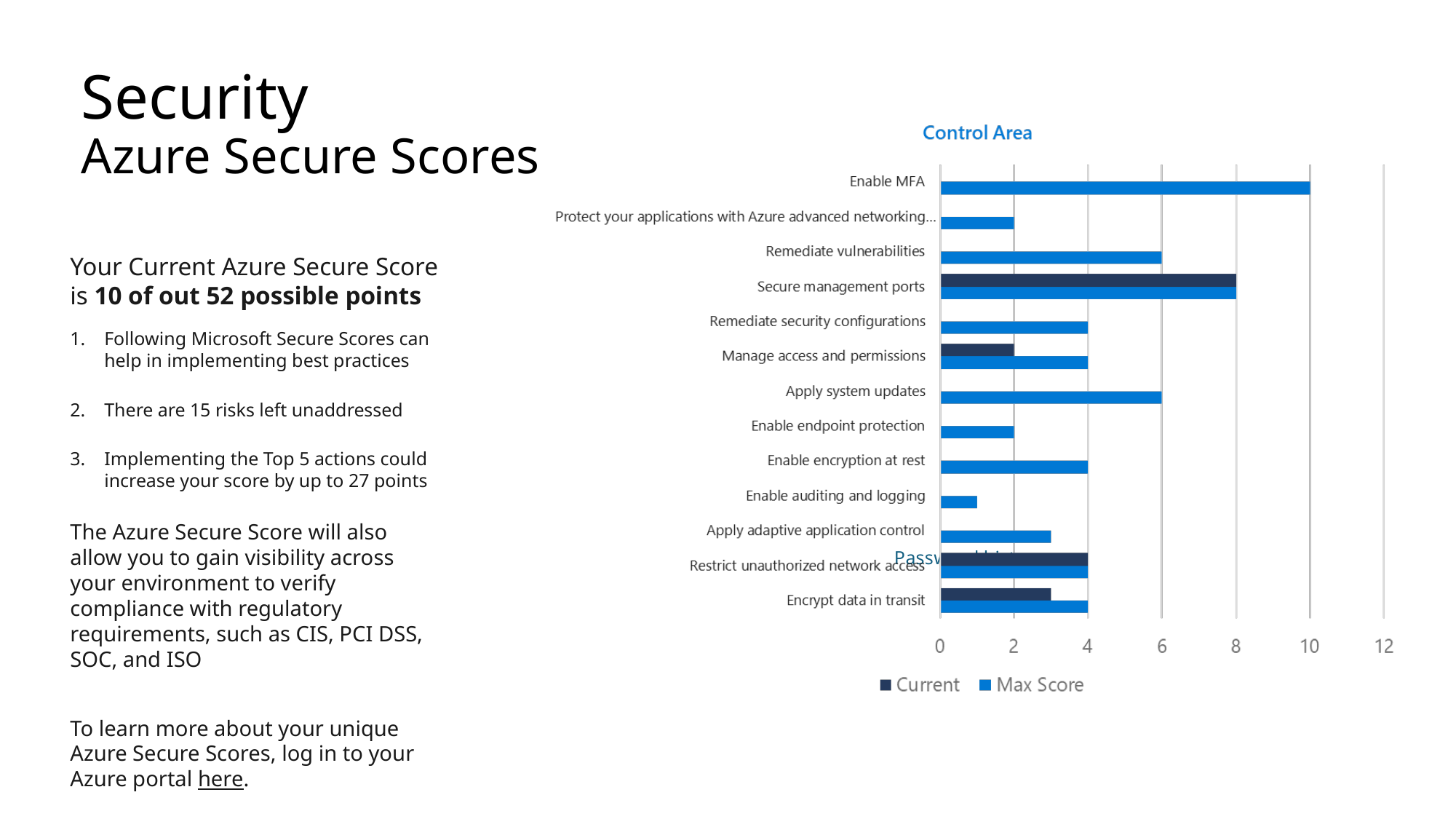
What is the Current value for Secure management ports? 8 What is the Max Score value for Enable MFA? 10 What are the two series named in the chart legend? Current and Max Score Which is larger, the Max Score for Apply system updates or the Max Score for Enable endpoint protection? Apply system updates Which control area has the highest Max Score? Enable MFA What type of chart is shown on the slide? bar chart What is the Max Score value for Remediate vulnerabilities? 6 How many control areas (categories) are plotted in the chart? 13 Which control area has the lowest Max Score? Enable auditing and logging Is the Max Score value for Apply adaptive application control greater or less than 4? less What is the difference between the Max Score and the Current value for Manage access and permissions? 2 How many series does the chart legend list? 2